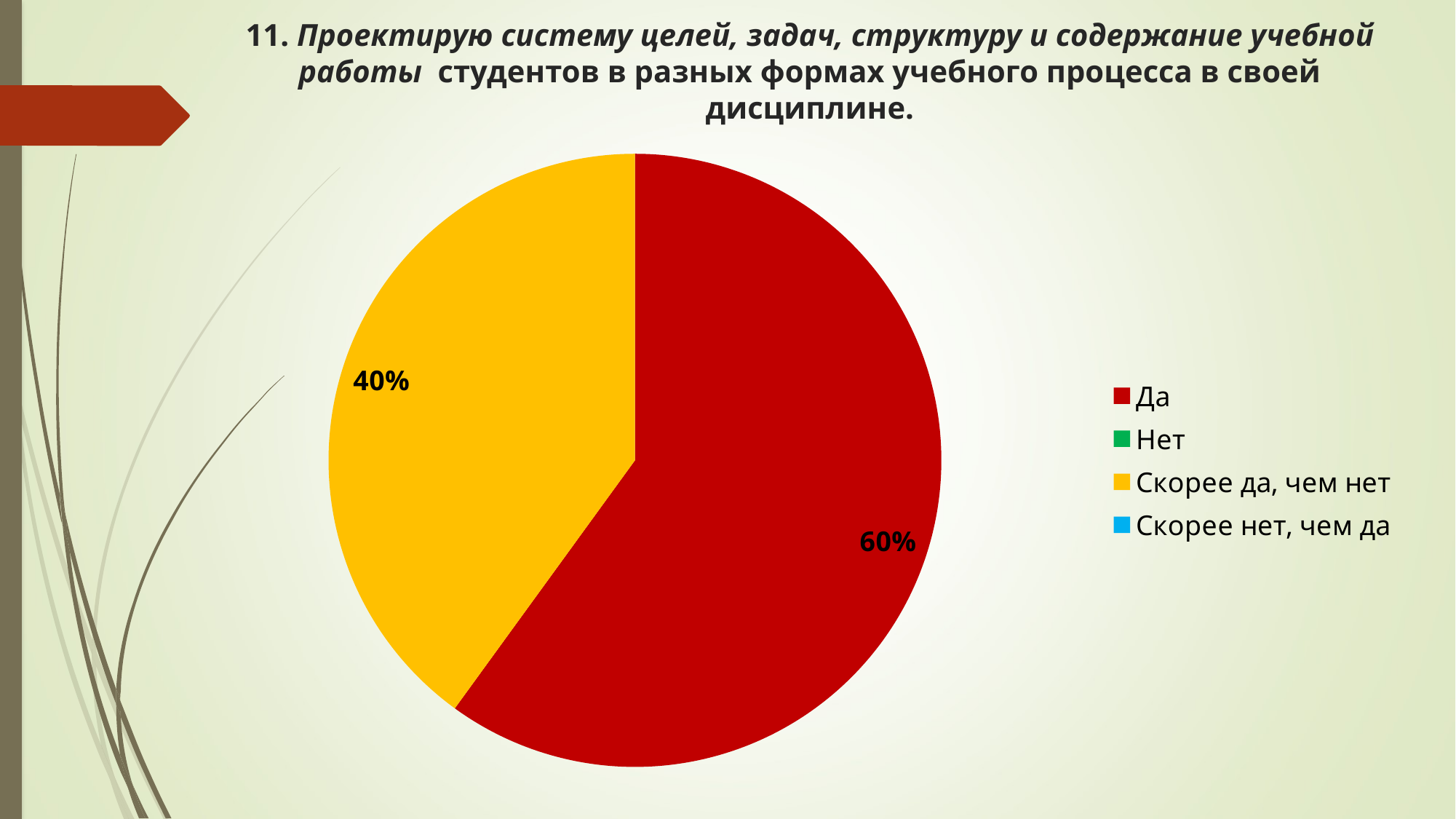
What kind of chart is shown on the slide? pie chart What colour is the slice for "Да"? red What share of the pie does "Скорее да, чем нет" take? 40% What share of the pie does "Да" take? 60% Which category has the largest slice of the pie? Да How many slices are visible in the pie? 2 Is the share for "Да" greater or less than 50%? greater What is the difference in percentage points between the "Да" slice and the "Скорее да, чем нет" slice? 20% Which of the two visible slices is larger, "Да" or "Скорее да, чем нет"? Да How many entries does the legend list? 4 What colour is the slice for "Скорее да, чем нет"? yellow